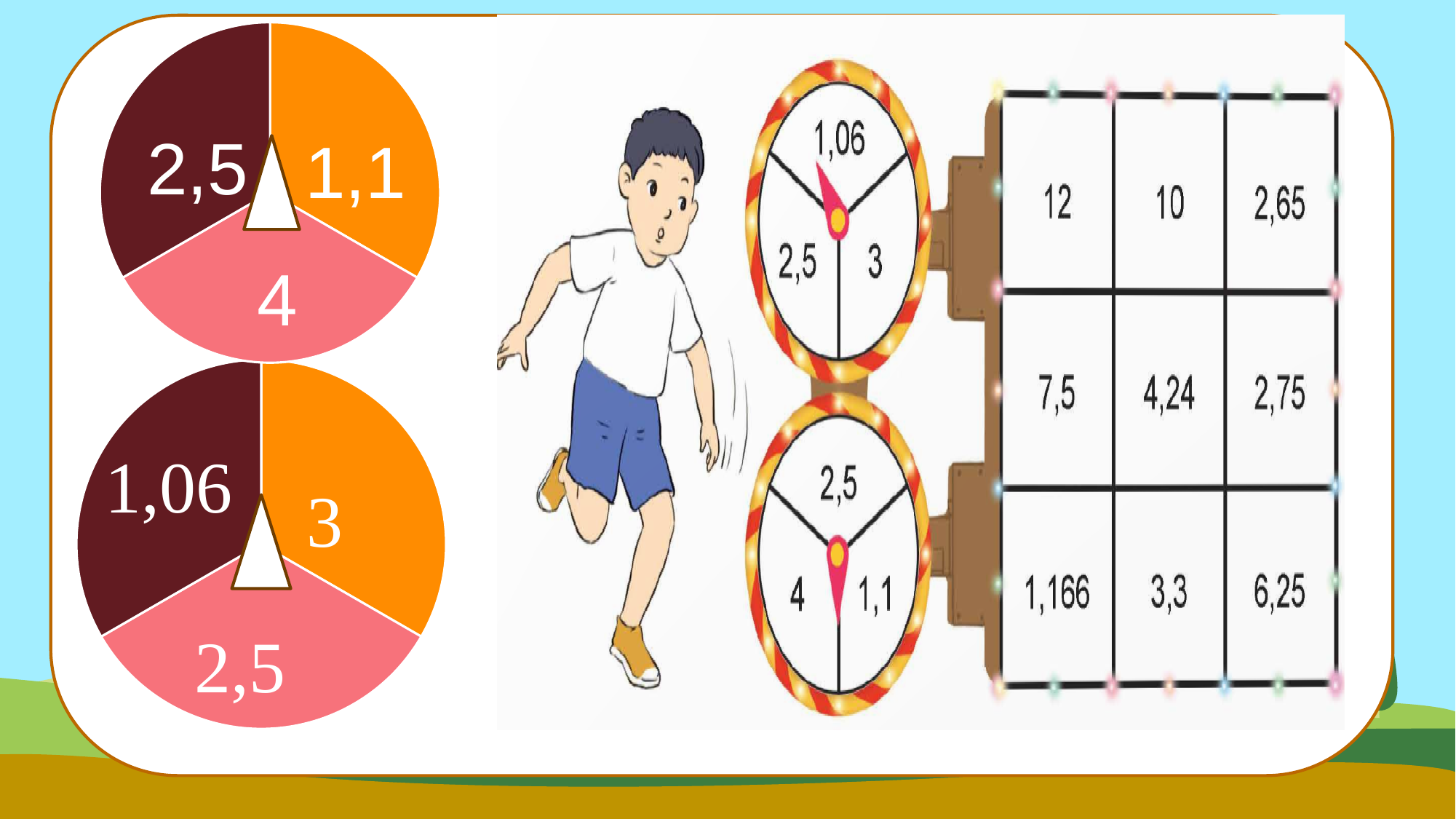
In the top-left pie chart, what label is shown on the orange slice? 1,1 In the top-left pie chart, what label is shown on the dark red slice? 2,5 How many slices does the top-left pie chart have? 3 In the bottom-left pie chart, what label is shown on the pink slice? 2,5 In the bottom-left pie chart, what label is shown on the dark red slice? 1,06 What kind of chart is the top-left chart on the slide? pie chart In the top-left pie chart, what label is shown on the pink slice? 4 In the bottom-left pie chart, what label is shown on the orange slice? 3 What colour is the slice labelled 1,06 in the bottom-left pie chart? dark red Which label appears on a slice in both the top-left and bottom-left pie charts? 2,5 How many slices does the bottom-left pie chart have? 3